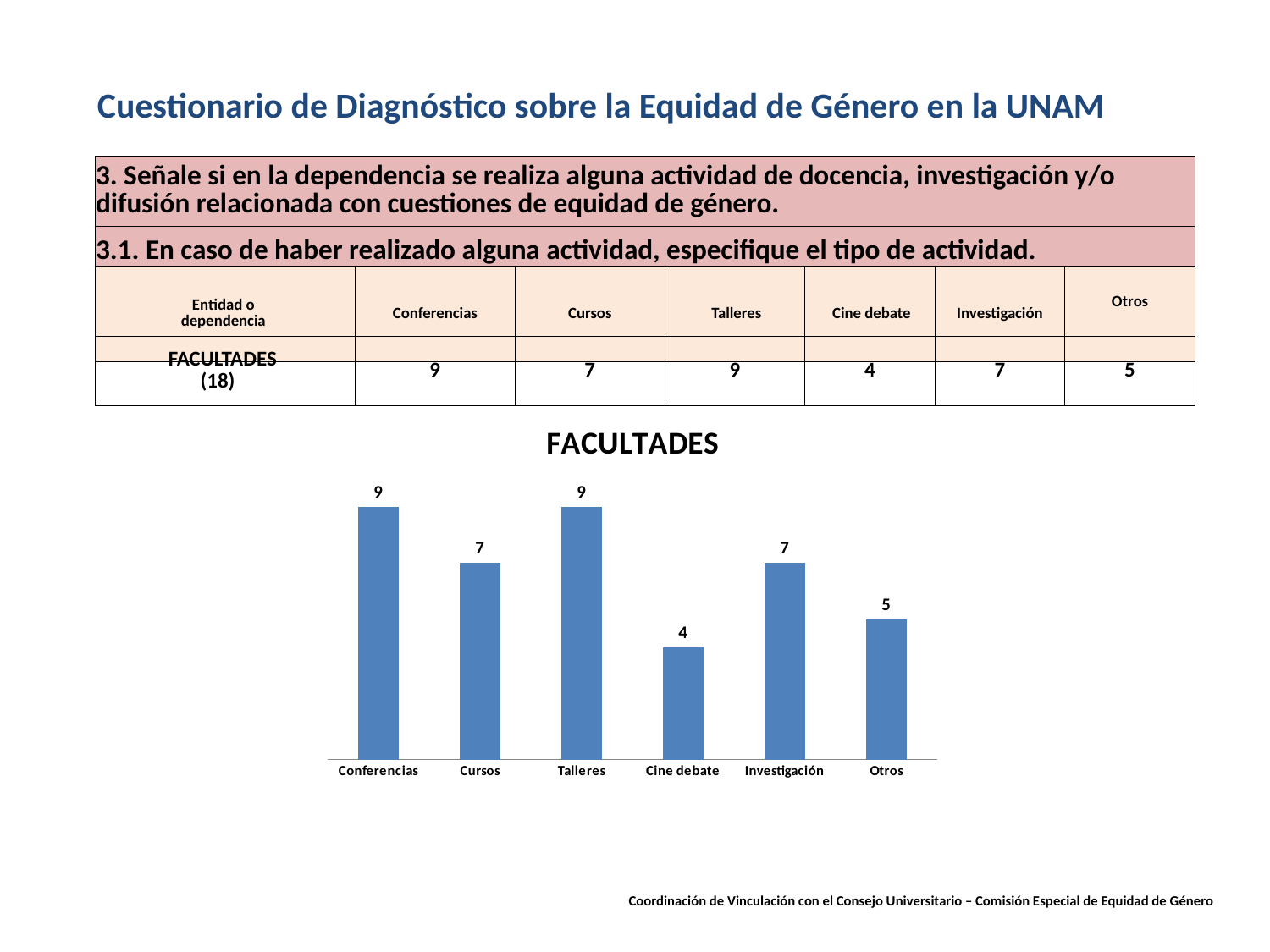
What is the difference between the values for Talleres and Cine debate in the FACULTADES chart? 5 Which is larger in the FACULTADES chart, the value for Cursos or the value for Cine debate? Cursos What is the value for Otros in the FACULTADES chart? 5 What is the value for Cine debate in the FACULTADES chart? 4 What is the value for Conferencias in the FACULTADES chart? 9 How many categories are shown in the FACULTADES chart? 6 Which is larger in the FACULTADES chart, the value for Otros or the value for Investigación? Investigación What is the value for Investigación in the FACULTADES chart? 7 What is the difference between the values for Cursos and Otros in the FACULTADES chart? 2 Which category has the lowest value in the FACULTADES chart? Cine debate What is the title of the chart on the slide? FACULTADES What kind of chart is the FACULTADES chart? Bar chart